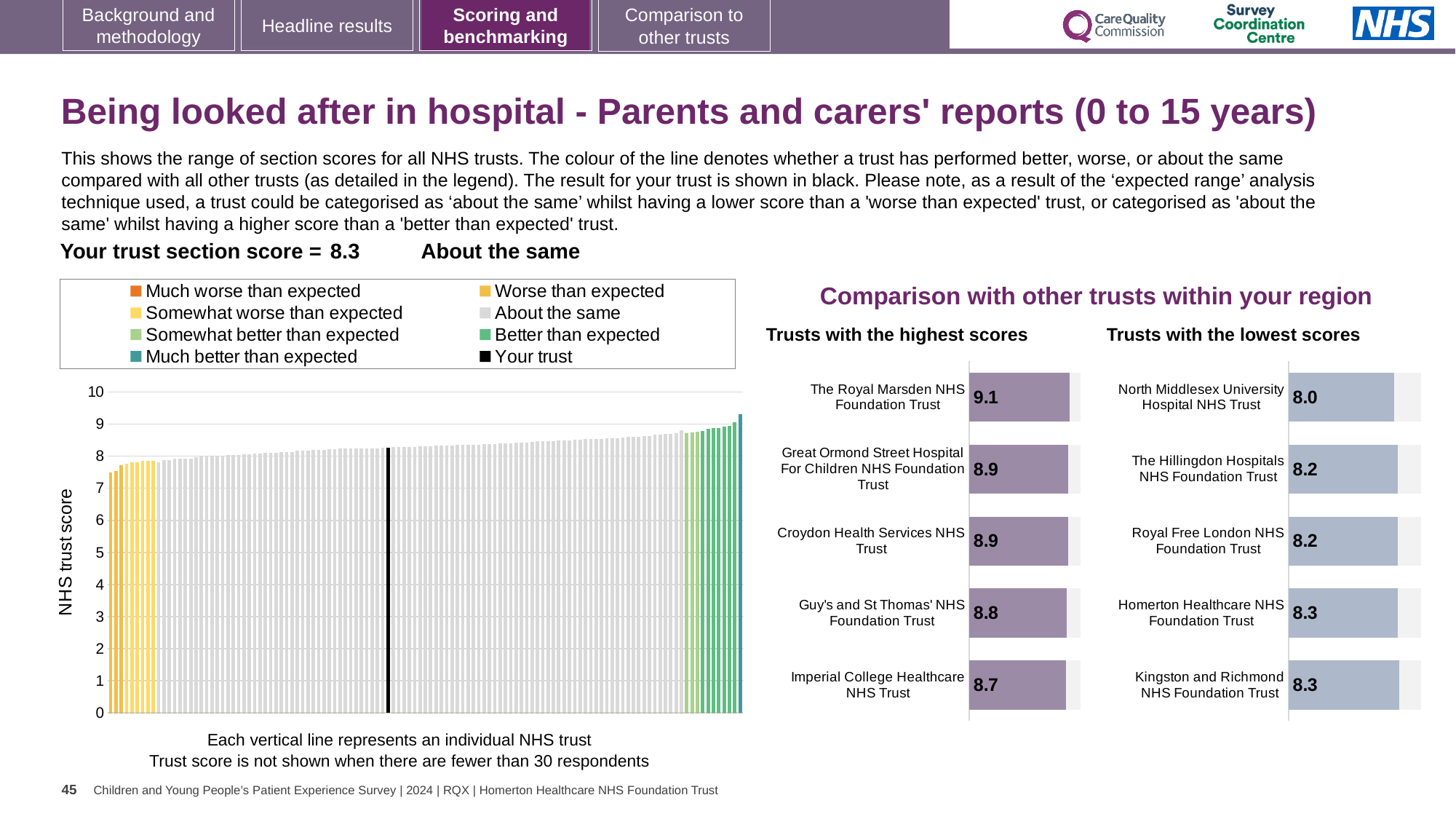
In the large chart on the left, do the trust scores rise or fall from left to right along the x axis? rise In the 'Trusts with the lowest scores' chart, what is the score for The Hillingdon Hospitals NHS Foundation Trust? 8.2 How many trusts are shown in the 'Trusts with the highest scores' chart? 5 In the 'Trusts with the highest scores' chart, what is the score for Imperial College Healthcare NHS Trust? 8.7 How many entries does the legend of the large chart on the left list? 8 In the 'Trusts with the lowest scores' chart, which has the larger score: Homerton Healthcare NHS Foundation Trust or North Middlesex University Hospital NHS Trust? Homerton Healthcare NHS Foundation Trust In the 'Trusts with the highest scores' chart, which trust has the highest score? The Royal Marsden NHS Foundation Trust In the 'Trusts with the highest scores' chart, what is the score for The Royal Marsden NHS Foundation Trust? 9.1 In the 'Trusts with the lowest scores' chart, which trust has the lowest score? North Middlesex University Hospital NHS Trust In the 'Trusts with the highest scores' chart, what is the difference between the scores of The Royal Marsden NHS Foundation Trust and Imperial College Healthcare NHS Trust? 0.4 In the 'Trusts with the lowest scores' chart, what is the score for North Middlesex University Hospital NHS Trust? 8.0 In the large chart on the left, is the value for 'Your trust' (the black line) greater or less than 9? less